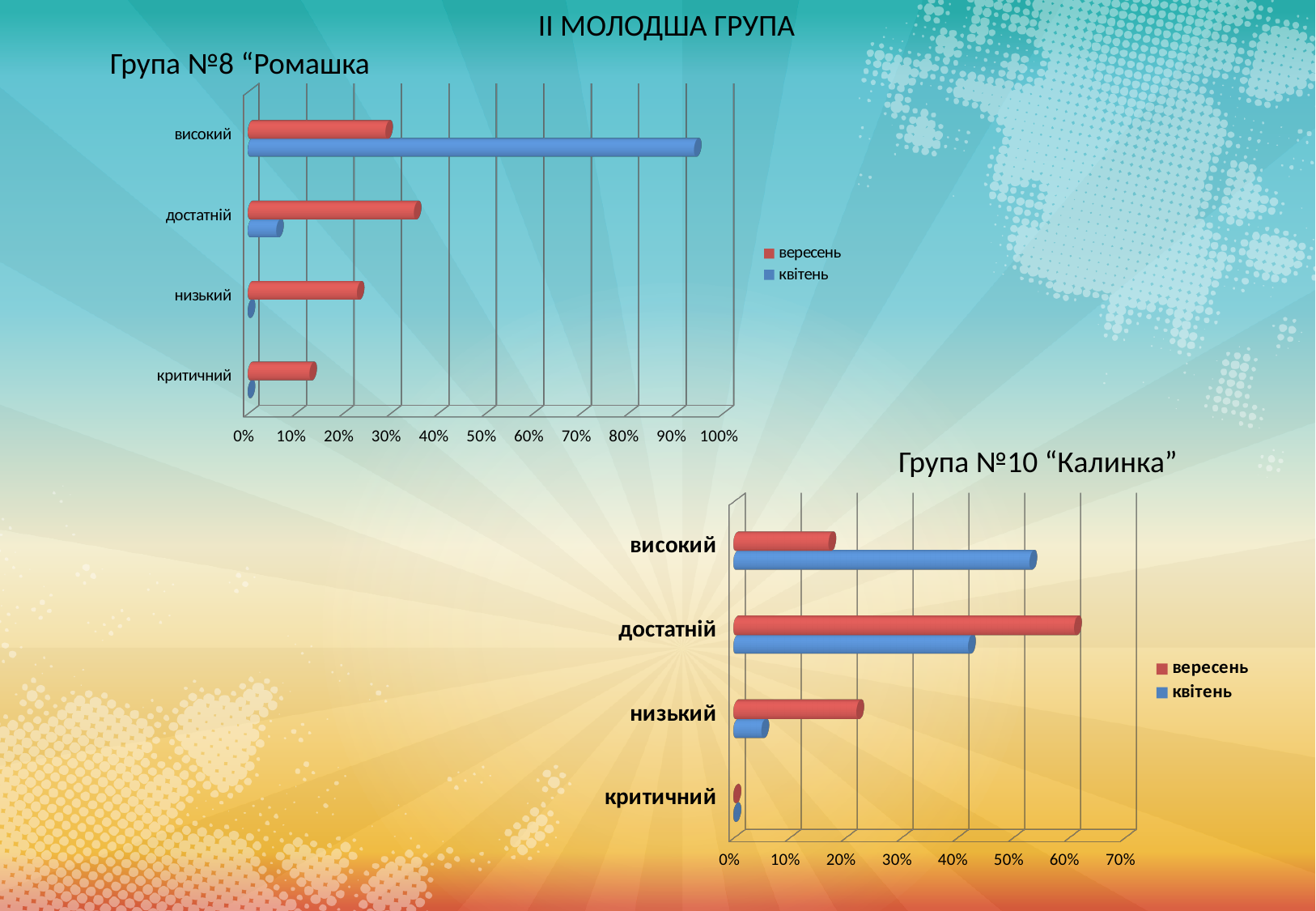
In the "Група №8 "Ромашка"" chart, which category has the highest value for квітень? високий What kind of chart is the "Група №8 "Ромашка"" chart? bar chart In the "Група №8 "Ромашка"" chart, for достатній, which series has the larger value, вересень or квітень? вересень In the "Група №8 "Ромашка"" chart, which category has the lowest value for вересень? критичний In the "Група №10 "Калинка"" chart, for високий, which series has the larger value, вересень or квітень? квітень In the "Група №10 "Калинка"" chart, which category has the highest value for вересень? достатній How many categories are shown on the "Група №8 "Ромашка"" chart? 4 How many series does the legend of the "Група №10 "Калинка"" chart list? 2 In the "Група №10 "Калинка"" chart, is the квітень value for низький greater or less than 10%? less In the "Група №8 "Ромашка"" chart, is the квітень value for високий greater or less than 90%? greater In the "Група №10 "Калинка"" chart, which colour represents the квітень series? blue